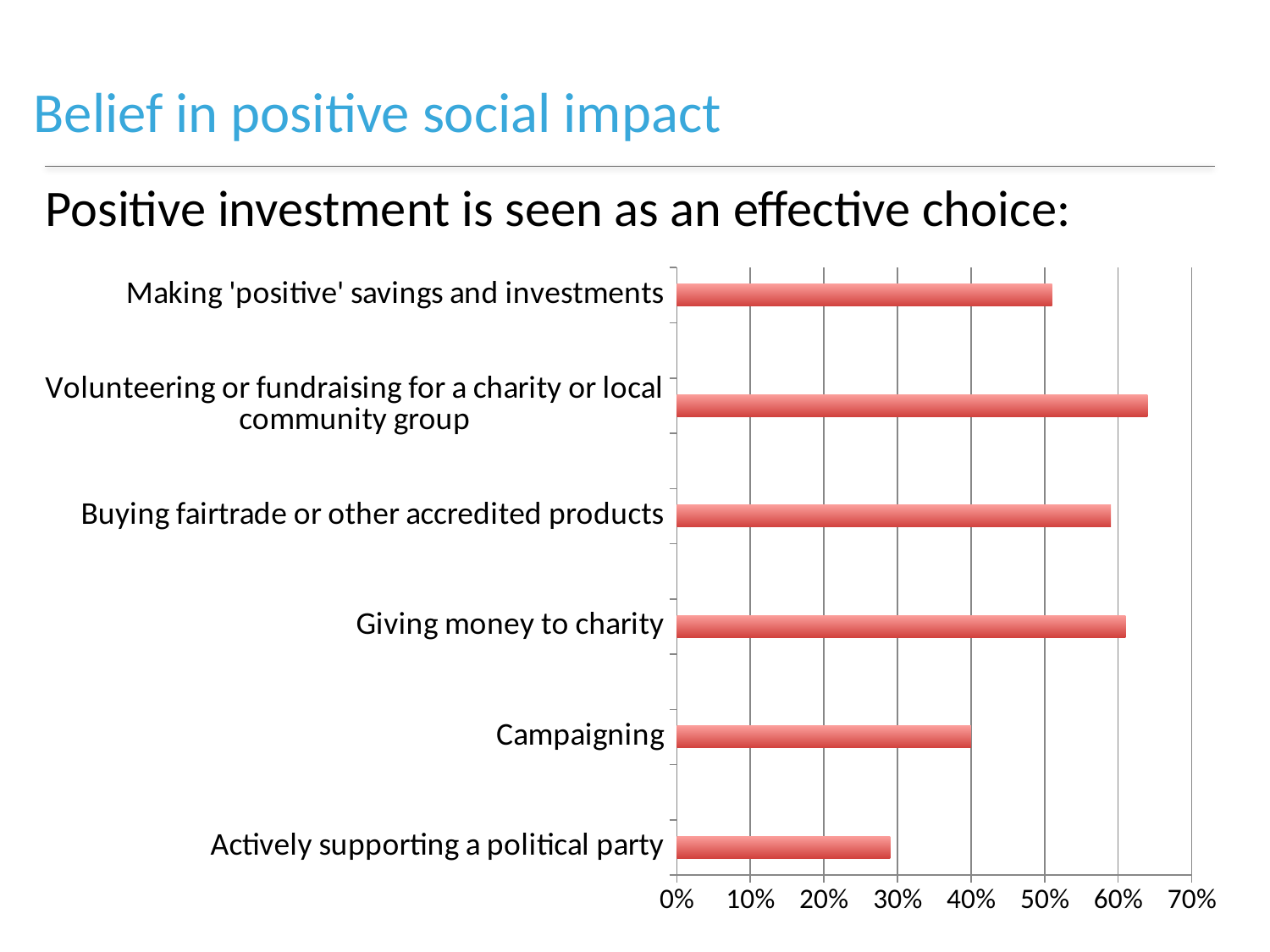
Which is larger: the value for Volunteering or fundraising for a charity or local community group or the value for Making 'positive' savings and investments? Volunteering or fundraising for a charity or local community group How many categories are plotted in the chart? 6 Which category has the lowest value in the chart? Actively supporting a political party Is the value for Volunteering or fundraising for a charity or local community group greater or less than 60%? greater Which category has the highest value in the chart? Volunteering or fundraising for a charity or local community group Is the value for Campaigning greater or less than 50%? less Is the value for Actively supporting a political party greater or less than 40%? less Which is larger: the value for Campaigning or the value for Actively supporting a political party? Campaigning What kind of chart is shown on the slide? bar chart What is the highest value shown on the horizontal axis of the chart? 70%